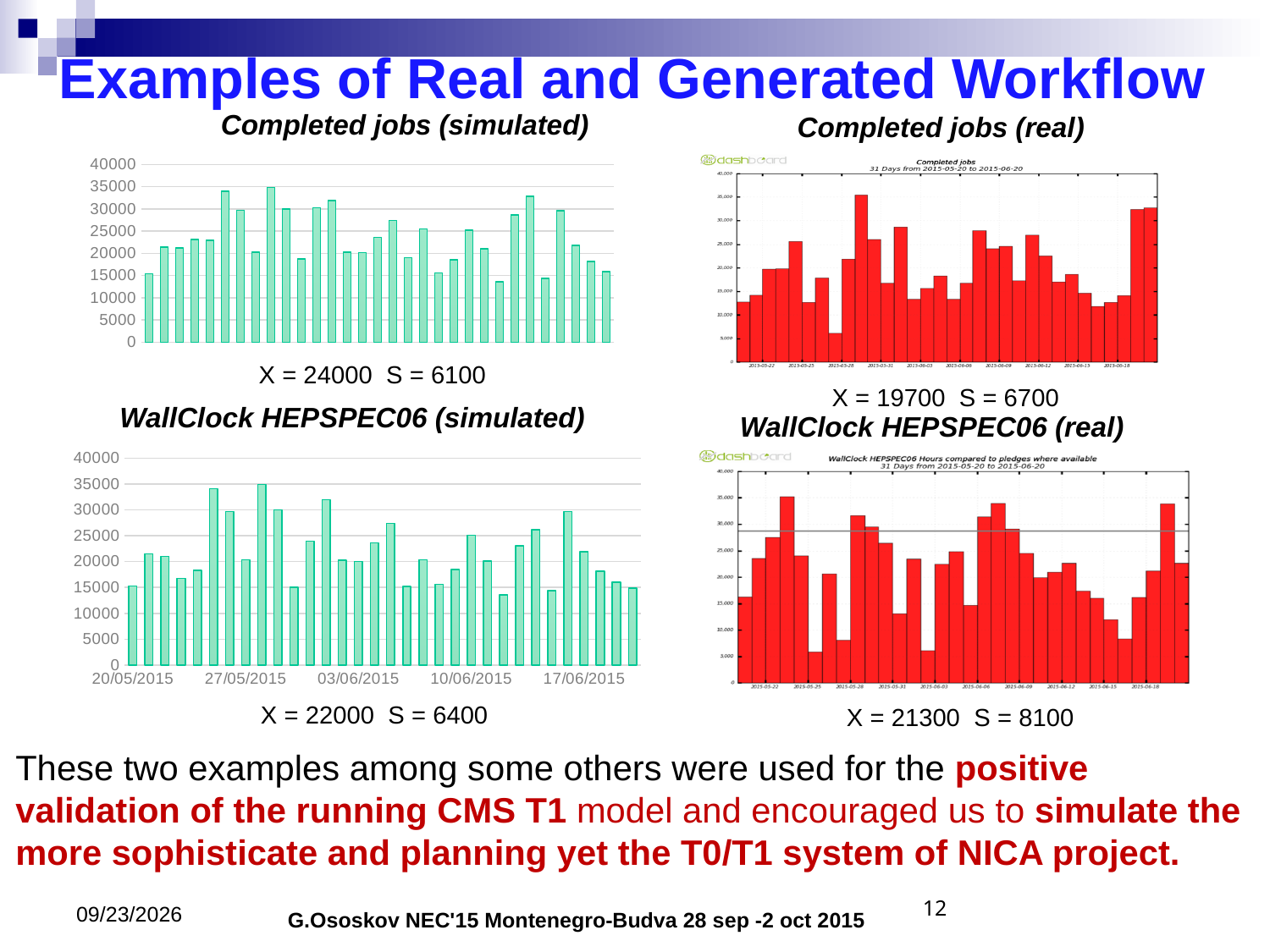
In the Completed jobs (simulated) chart, is the tallest bar greater or less than 30000? greater What is the first date label on the x axis of the WallClock HEPSPEC06 (simulated) chart? 20/05/2015 What kind of chart is the Completed jobs (simulated) chart? bar chart In the WallClock HEPSPEC06 (simulated) chart, is the tallest bar greater or less than 30000? greater What is the maximum value shown on the y axis of the Completed jobs (simulated) chart? 40000 What kind of chart is the WallClock HEPSPEC06 (real) chart? bar chart In the Completed jobs (real) chart, is the shortest bar greater or less than 10000? less How many date labels are shown on the x axis of the WallClock HEPSPEC06 (simulated) chart? 5